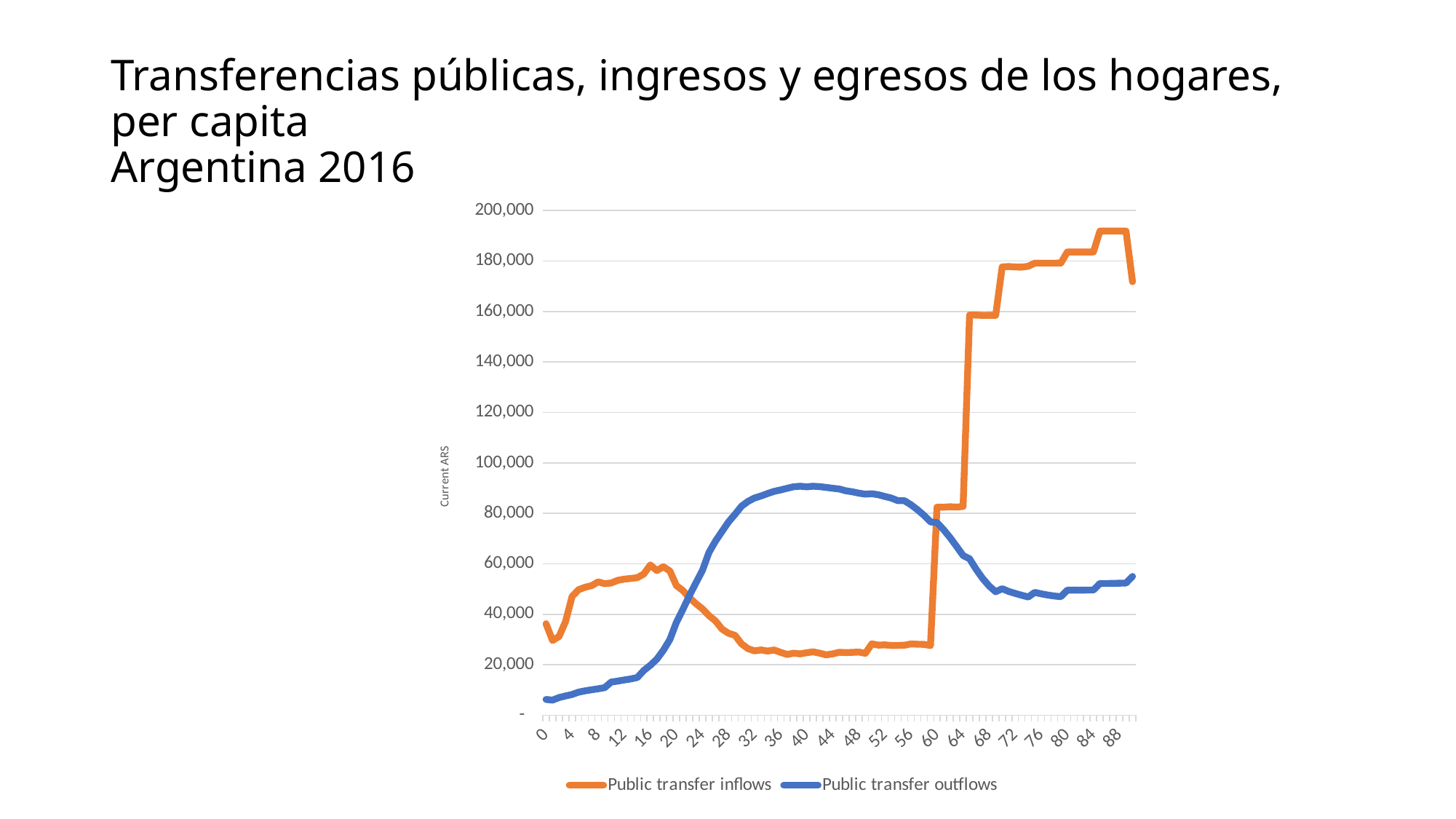
Is the value for Public transfer outflows at age 40 greater or less than 80,000? greater What kind of chart is shown on the slide? line chart Is the value for Public transfer inflows at age 80 greater or less than 160,000? greater What are the two series named in the legend? Public transfer inflows and Public transfer outflows At age 40, which series has the higher value, Public transfer inflows or Public transfer outflows? Public transfer outflows Do the values for Public transfer outflows rise or fall between age 40 and age 68? fall At age 80, which series has the higher value, Public transfer inflows or Public transfer outflows? Public transfer inflows Is the value for Public transfer inflows at age 40 greater or less than 40,000? less What is the label on the vertical axis? Current ARS How many series does the legend list? 2 Do the values for Public transfer outflows rise or fall between age 0 and age 40? rise